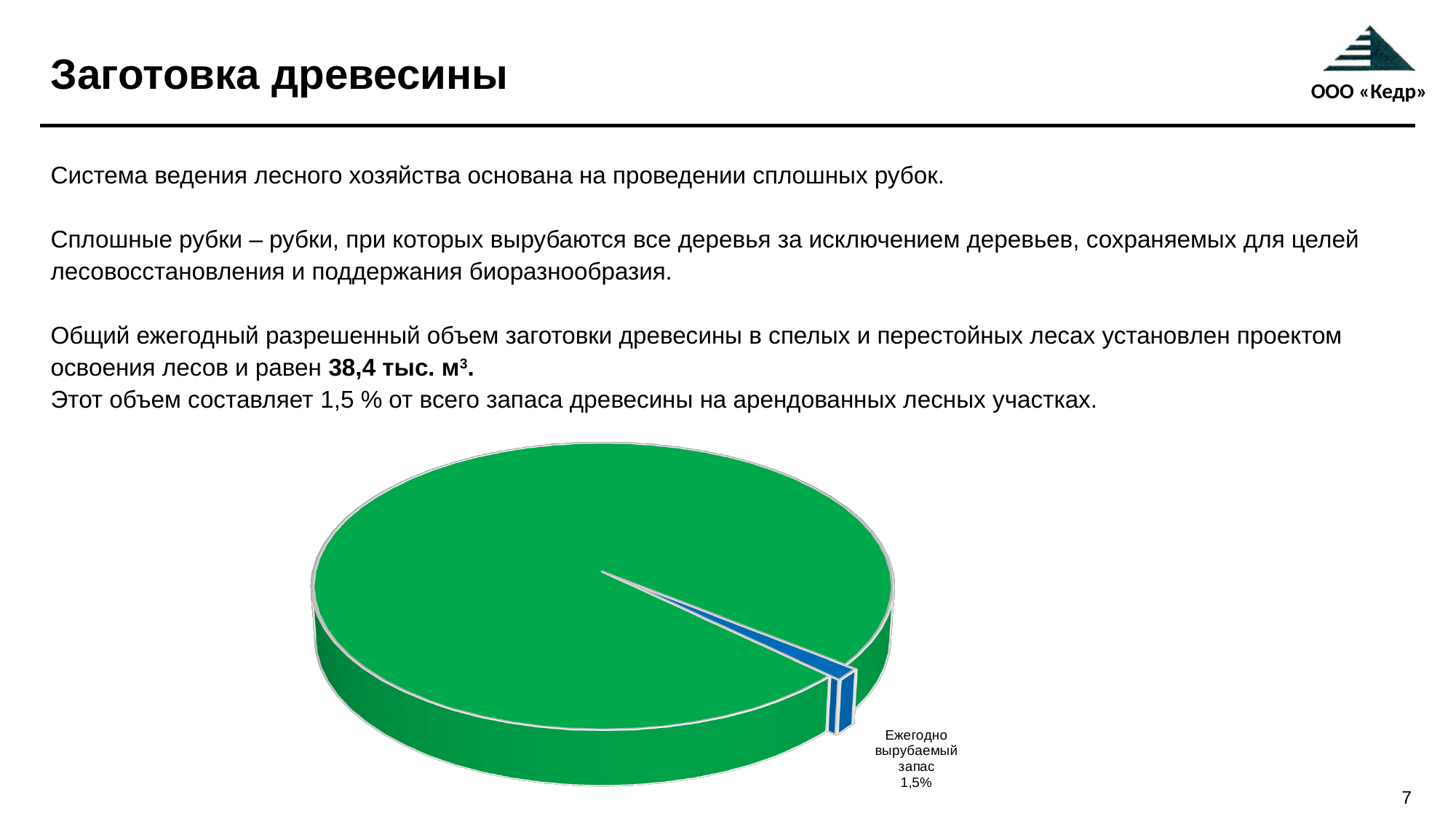
What share of the pie does the slice labelled "Ежегодно вырубаемый запас" represent? 1,5% Which slice of the pie is the smallest? Ежегодно вырубаемый запас What kind of chart is shown on the slide? pie chart Which slice is larger: the green slice or the blue slice labelled "Ежегодно вырубаемый запас"? the green slice How many slices does the pie chart have? 2 What value is printed for the slice "Ежегодно вырубаемый запас"? 1,5% What colour is the slice labelled "Ежегодно вырубаемый запас"? blue How many slices of the pie chart have a printed label? 1